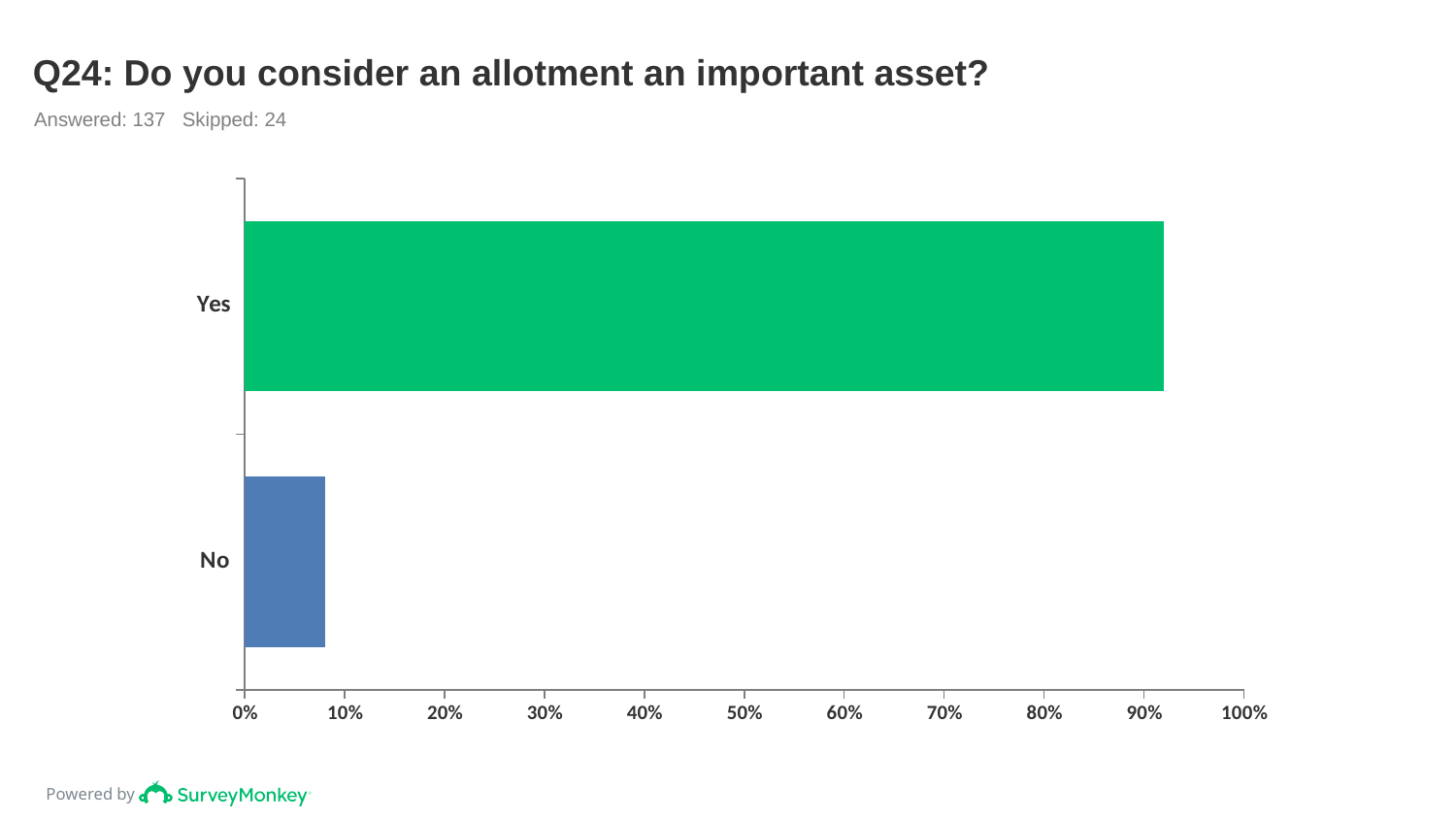
Which category has the lowest value? No Is the value for No greater or less than 10%? less Is the value for Yes greater or less than 50%? greater Is the value for Yes greater or less than 90%? greater How many respondents answered the question according to the slide? 137 What kind of chart is shown on the slide? bar chart Which is larger, the value for Yes or the value for No? Yes What is the title of the chart? Q24: Do you consider an allotment an important asset? How many categories are plotted in the chart? 2 Which category has the highest value? Yes